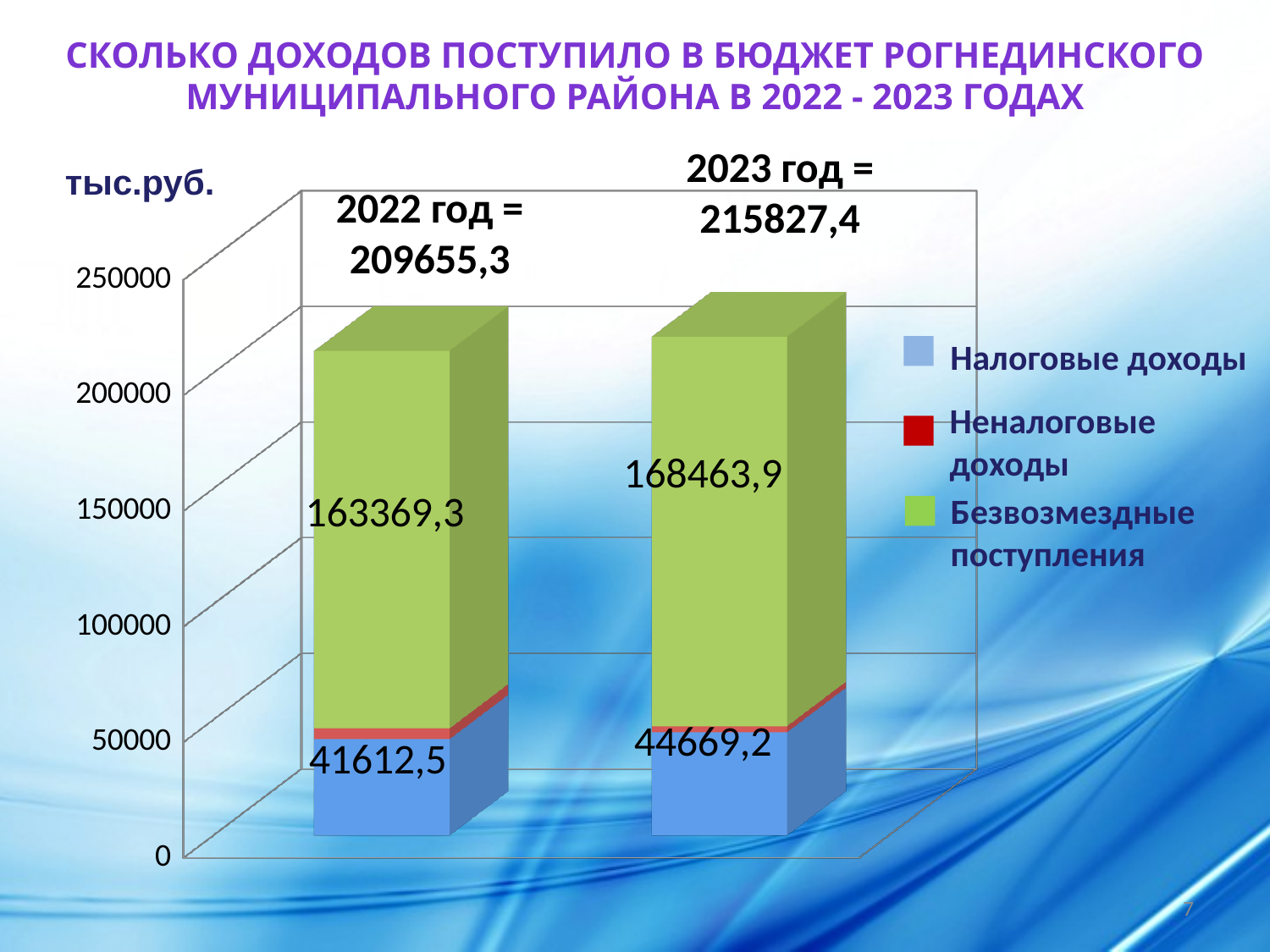
What is the difference between Безвозмездные поступления in 2023 and 2022? 5094,6 How many series does the legend list? 3 Does the total income rise or fall from 2022 to 2023? Rise What is the value of Налоговые доходы for 2022? 41612,5 By how much did the total budget income increase from 2022 to 2023? 6172,1 How many bars (years) are plotted in the chart? 2 What unit of measurement is indicated for the chart values? тыс.руб. What is the total of the 2023 bar? 215827,4 What is the total of the 2022 bar? 209655,3 What is the value of Безвозмездные поступления for 2023? 168463,9 Which year has the higher value of Налоговые доходы, 2022 or 2023? 2023 What type of chart is shown on the slide? Stacked bar chart